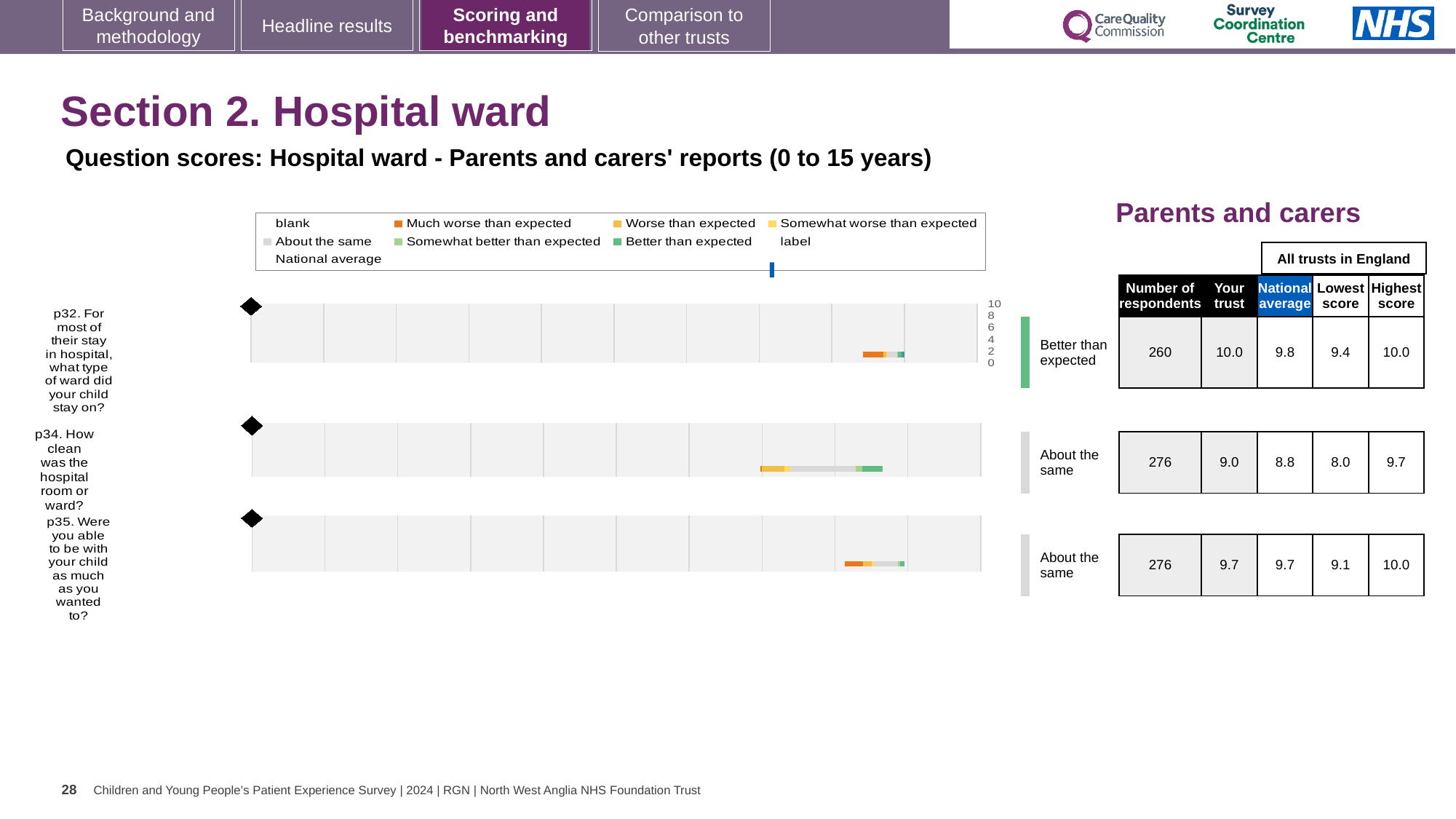
What is the 'Your trust' score for p32? 10.0 How many questions (categories) are plotted in the chart? 3 What is the national average score for p34? 8.8 Which question has the highest 'Your trust' score? p32 For p34, is the 'Your trust' score or the national average higher? Your trust How many respondents answered p35? 276 What is the highest score across all trusts in England for p34? 9.7 Which question has the lowest 'Your trust' score? p34 Which benchmark band is shown for p32 (what type of ward did your child stay on)? Better than expected What kind of chart is used to show the question scores on this slide? bar chart Which benchmark band is shown for p34 (how clean was the hospital room or ward)? About the same What is the difference between the highest score and the lowest score for p34? 1.7